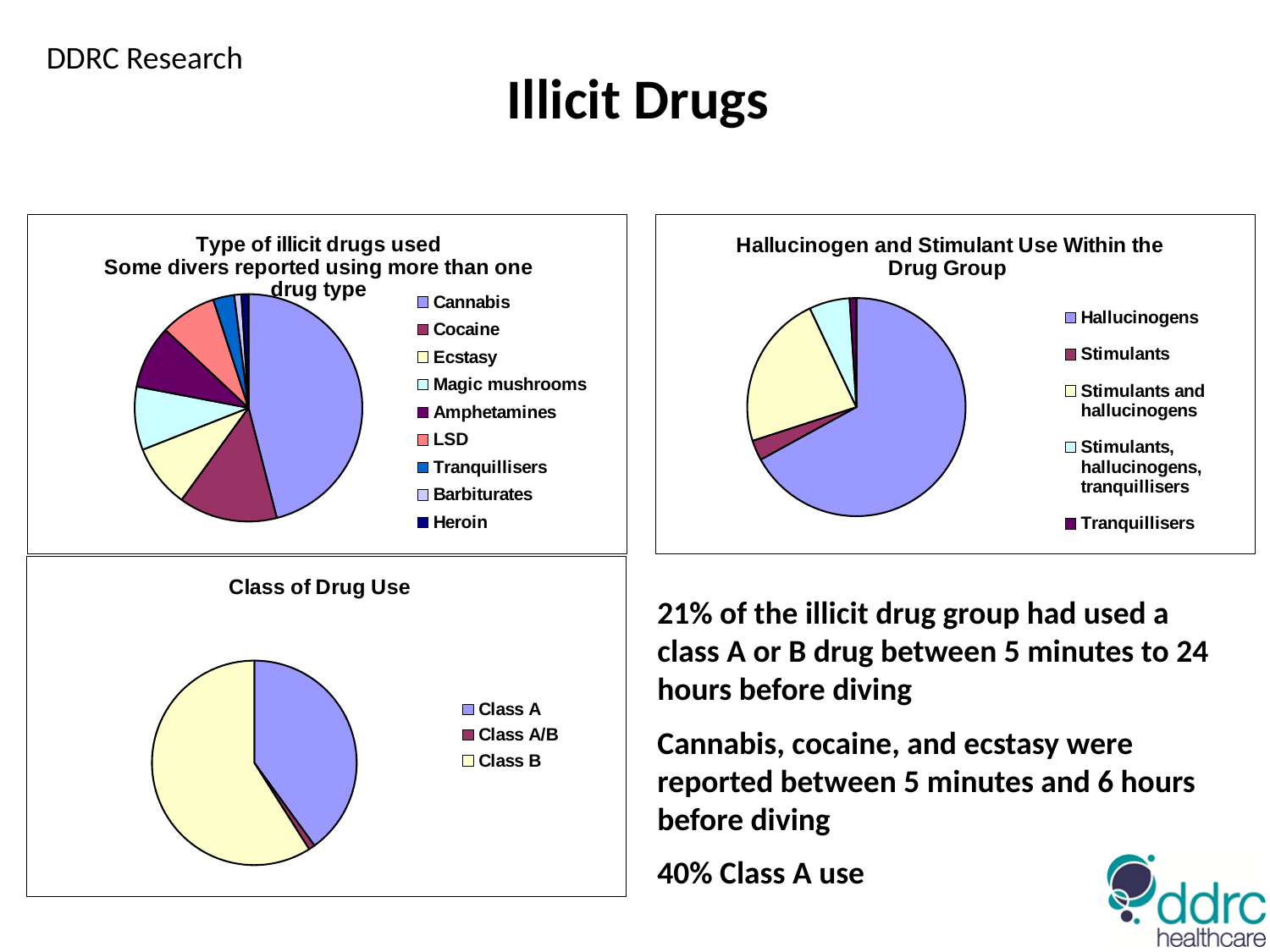
In the "Class of Drug Use" chart, how many classes does the legend list? 3 In the "Hallucinogen and Stimulant Use Within the Drug Group" chart, how many categories does the legend list? 5 What kind of chart is the "Class of Drug Use" chart? pie chart In the "Hallucinogen and Stimulant Use Within the Drug Group" chart, which slice is larger, Stimulants or Stimulants and hallucinogens? Stimulants and hallucinogens In the "Type of illicit drugs used" chart, how many drug types does the legend list? 9 In the "Type of illicit drugs used" chart, which drug type has the largest slice? Cannabis In the "Hallucinogen and Stimulant Use Within the Drug Group" chart, which category has the largest slice? Hallucinogens In the "Type of illicit drugs used" chart, which slice is larger, Cocaine or LSD? Cocaine In the "Class of Drug Use" chart, which class has the largest slice? Class B In the "Class of Drug Use" chart, which class has the smallest slice? Class A/B How many pie charts are shown on the slide? 3 In the "Hallucinogen and Stimulant Use Within the Drug Group" chart, which category has the smallest slice? Tranquillisers